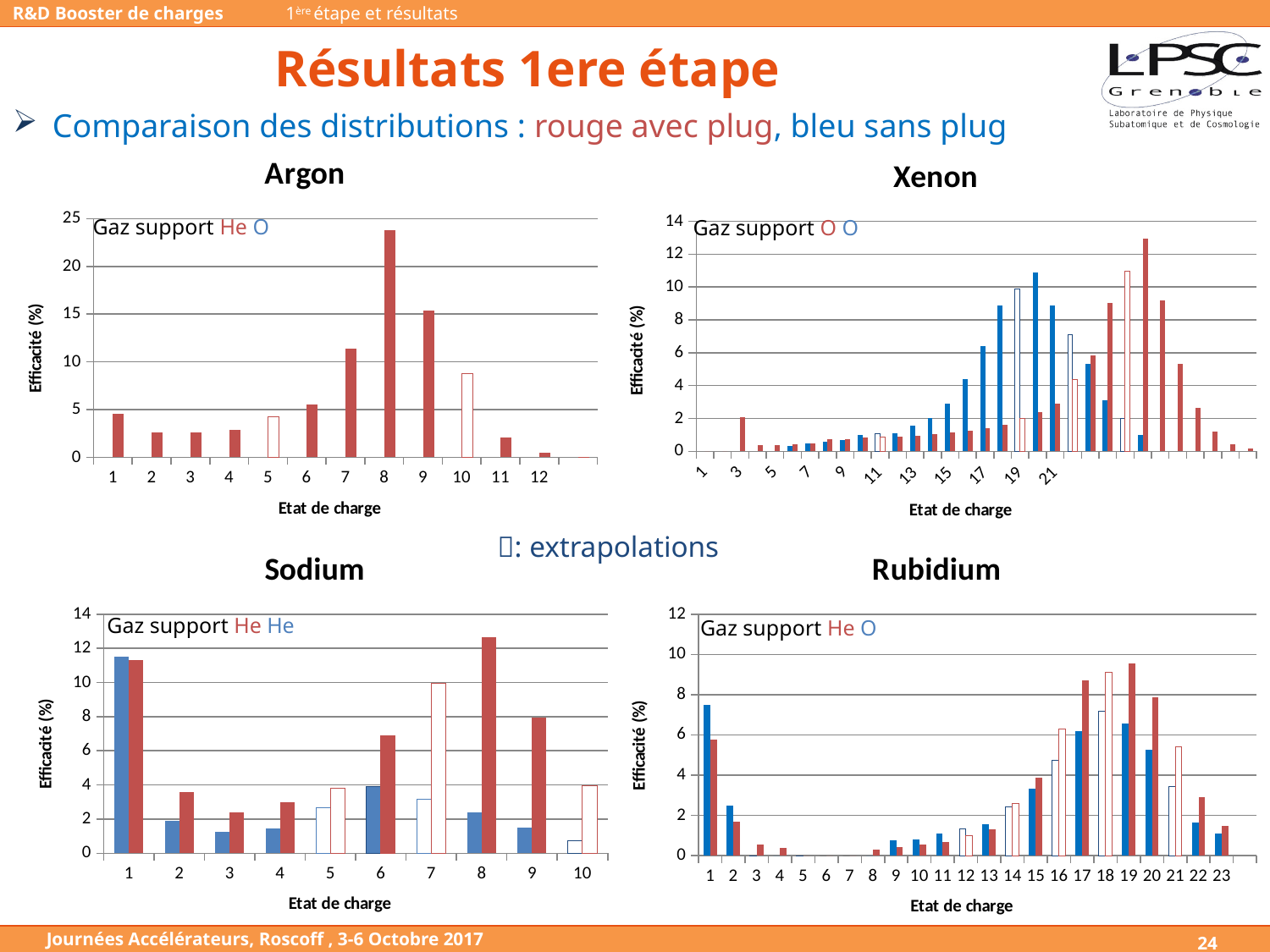
What kind of chart is the Argon chart? bar chart In the Sodium chart, at charge state 2, which is larger, the red bar or the blue bar? red In the Sodium chart, is the red value for charge state 8 greater or less than 12? greater In the Sodium chart, which charge state has the highest blue bar? 1 What is the y-axis label on the Xenon chart? Efficacité (%) In the Argon chart, is the value for charge state 8 greater or less than 20? greater In the Argon chart, which charge state (Etat de charge) has the highest red bar? 8 How many charge states are labelled on the x axis of the Rubidium chart? 23 In the Sodium chart, which charge state has the highest red bar? 8 In the Rubidium chart, is the red value for charge state 19 greater or less than 8? greater